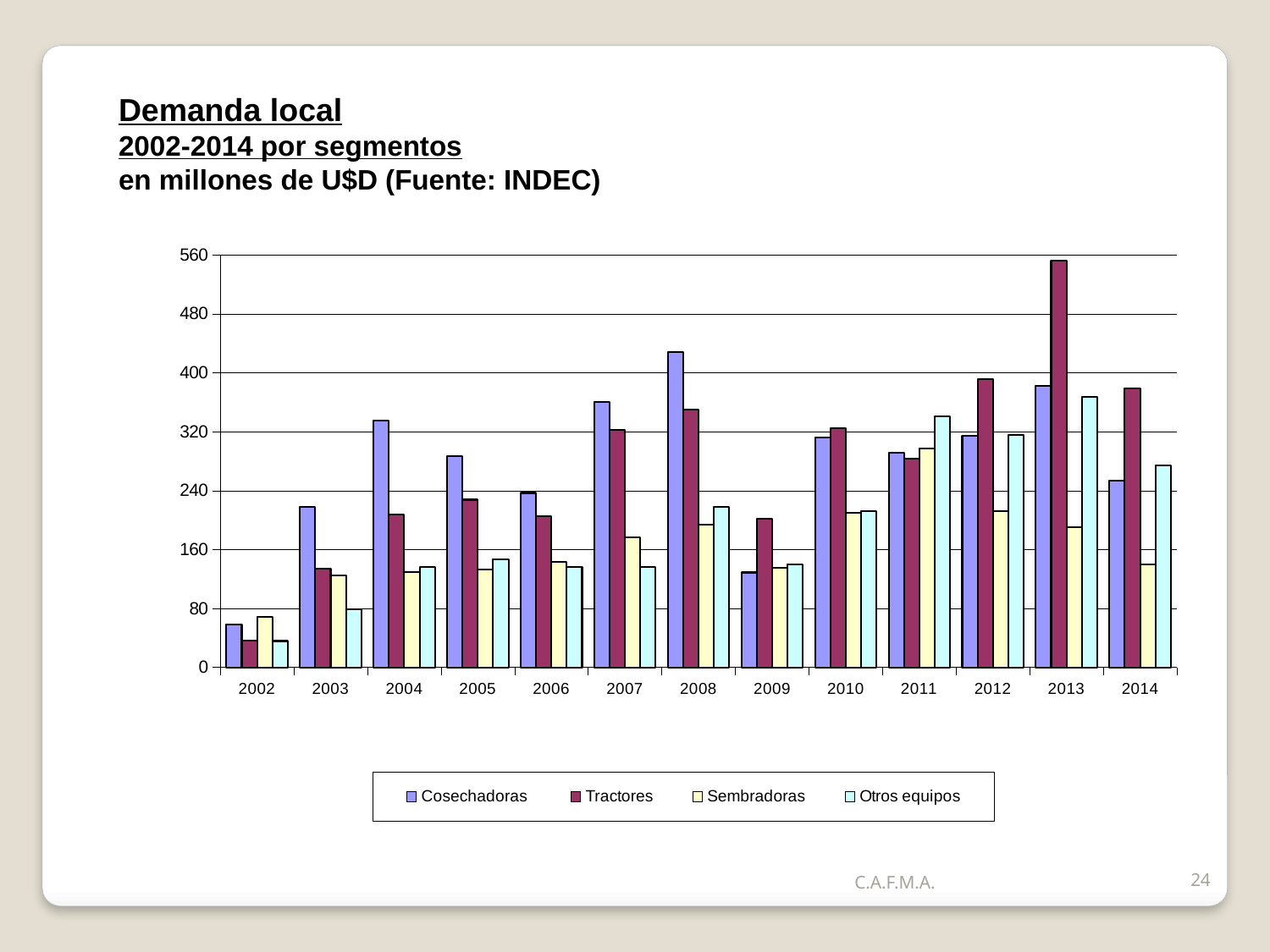
How many years are shown along the x axis? 13 In which year is the Tractores bar the highest? 2013 In which year is the Cosechadoras bar the lowest? 2002 What kind of chart is shown on the slide? bar chart In which year is the Cosechadoras bar the highest? 2008 Is the value for Cosechadoras in 2008 greater or less than 400? greater Is the value for Otros equipos in 2011 greater or less than 320? greater How many series does the legend list? 4 In 2004, which is larger: Cosechadoras or Tractores? Cosechadoras Which series is shown in the legend with the dark red/purple colour? Tractores In 2009, which is larger: Cosechadoras or Tractores? Tractores Is the value for Tractores in 2013 greater or less than 480? greater